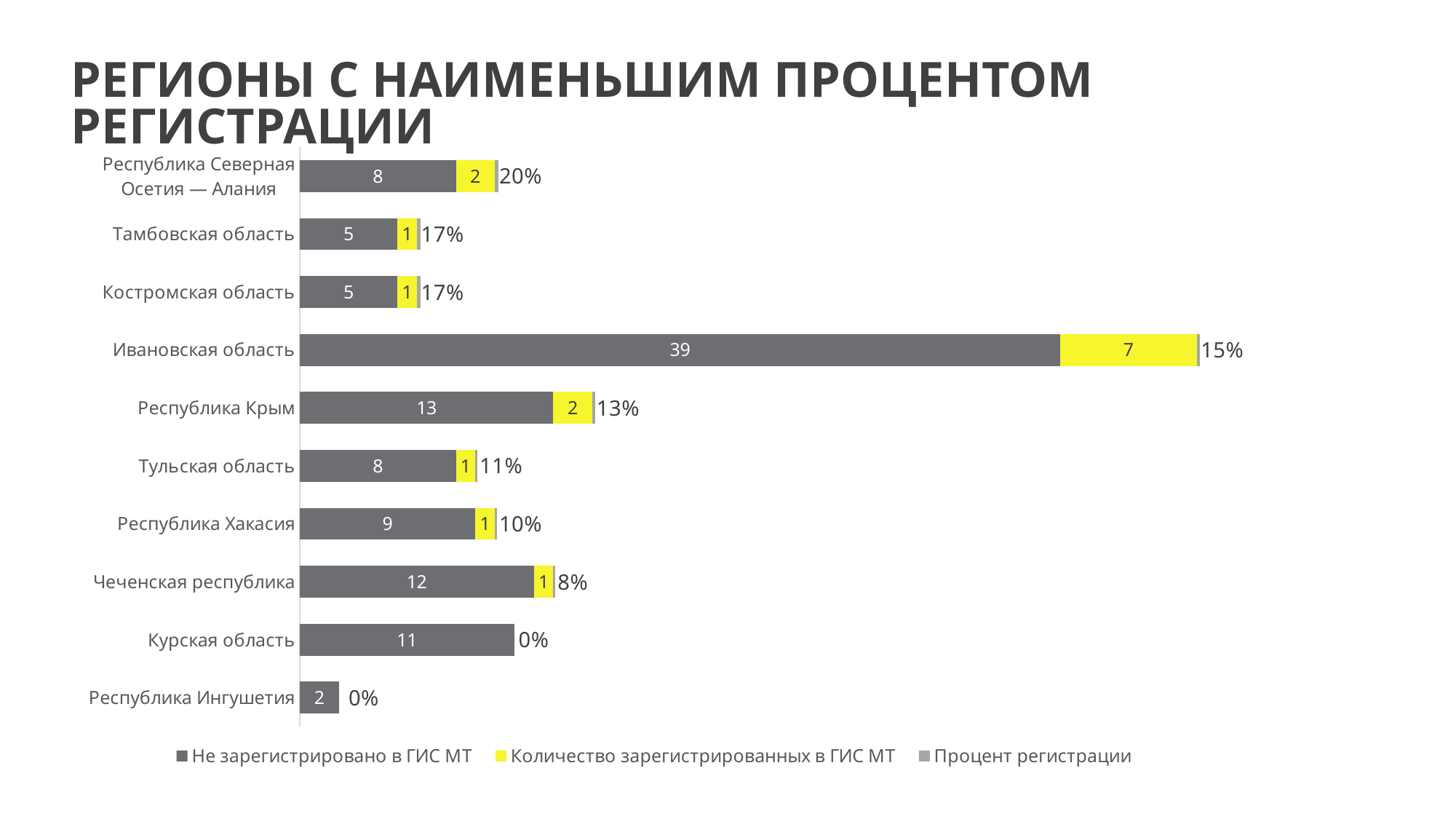
Which region has the highest value of 'Не зарегистрировано в ГИС МТ'? Ивановская область Which colour represents 'Количество зарегистрированных в ГИС МТ' in the legend? Yellow Which region has a larger 'Не зарегистрировано в ГИС МТ' value, Чеченская республика or Курская область? Чеченская республика What is the 'Процент регистрации' for Чеченская республика? 8% What is the value of 'Количество зарегистрированных в ГИС МТ' for Республика Северная Осетия — Алания? 2 What is the difference between the 'Не зарегистрировано в ГИС МТ' values for Ивановская область and Республика Крым? 26 What is the value of 'Не зарегистрировано в ГИС МТ' for Ивановская область? 39 What is the total of the 'Не зарегистрировано в ГИС МТ' and 'Количество зарегистрированных в ГИС МТ' values for Республика Крым? 15 What type of chart is shown on the slide? Stacked bar chart How many regions are listed on the chart? 10 Which region has the lowest value of 'Не зарегистрировано в ГИС МТ'? Республика Ингушетия How many series does the legend list? 3